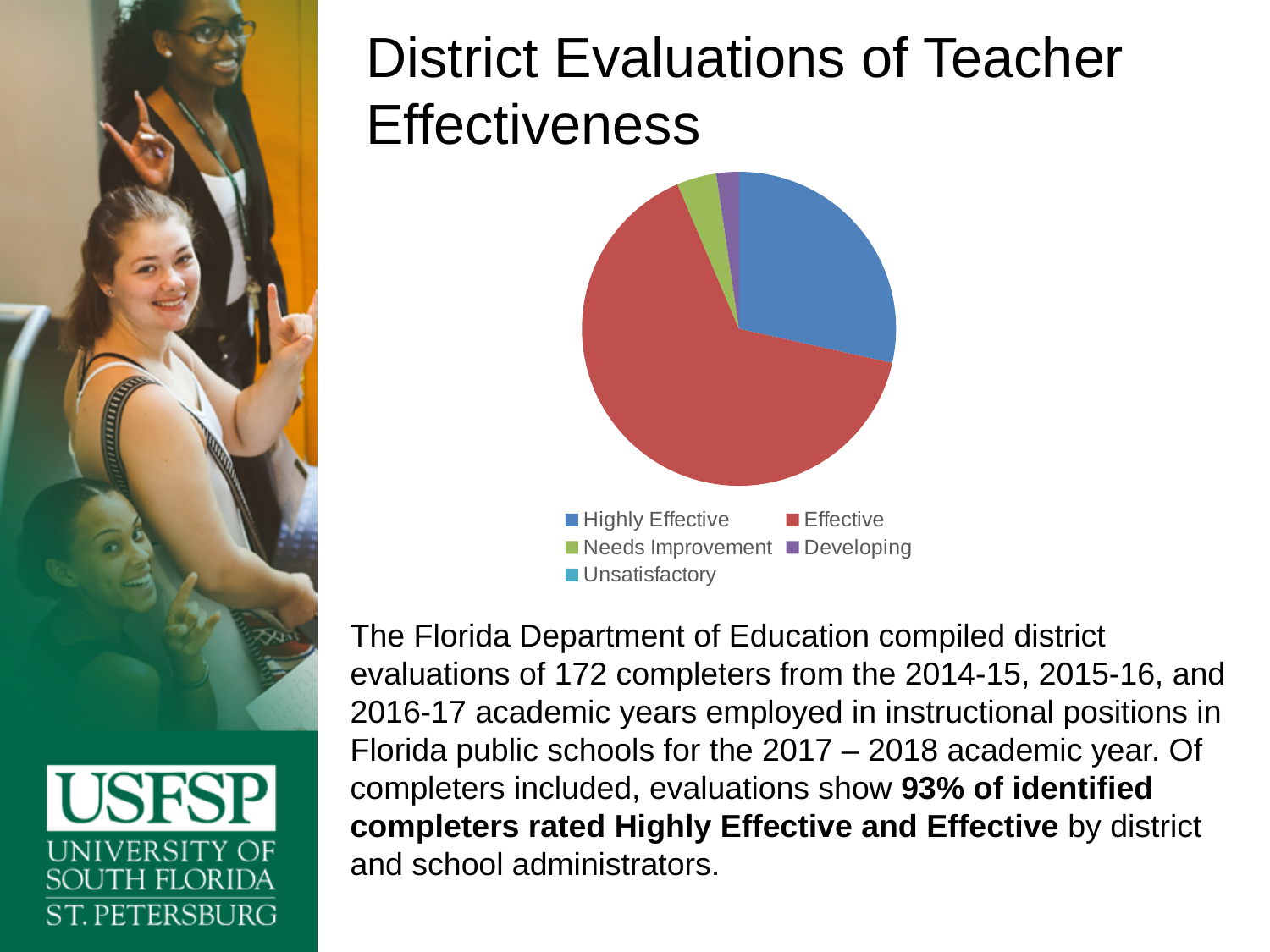
Which category has the second-largest slice of the pie chart? Highly Effective What is the title of the slide containing the pie chart? District Evaluations of Teacher Effectiveness Which is larger in the pie chart, the Needs Improvement slice or the Developing slice? Needs Improvement How many categories does the legend of the pie chart list? 5 What kind of chart is shown on the slide? pie chart Is the Highly Effective slice greater or less than half of the pie chart? less What colour represents the Effective category in the pie chart? red Is the Effective slice greater or less than half of the pie chart? greater Which is larger in the pie chart, the Effective slice or the Highly Effective slice? Effective Which category has the largest slice of the pie chart? Effective Which is larger in the pie chart, the Highly Effective slice or the Needs Improvement slice? Highly Effective